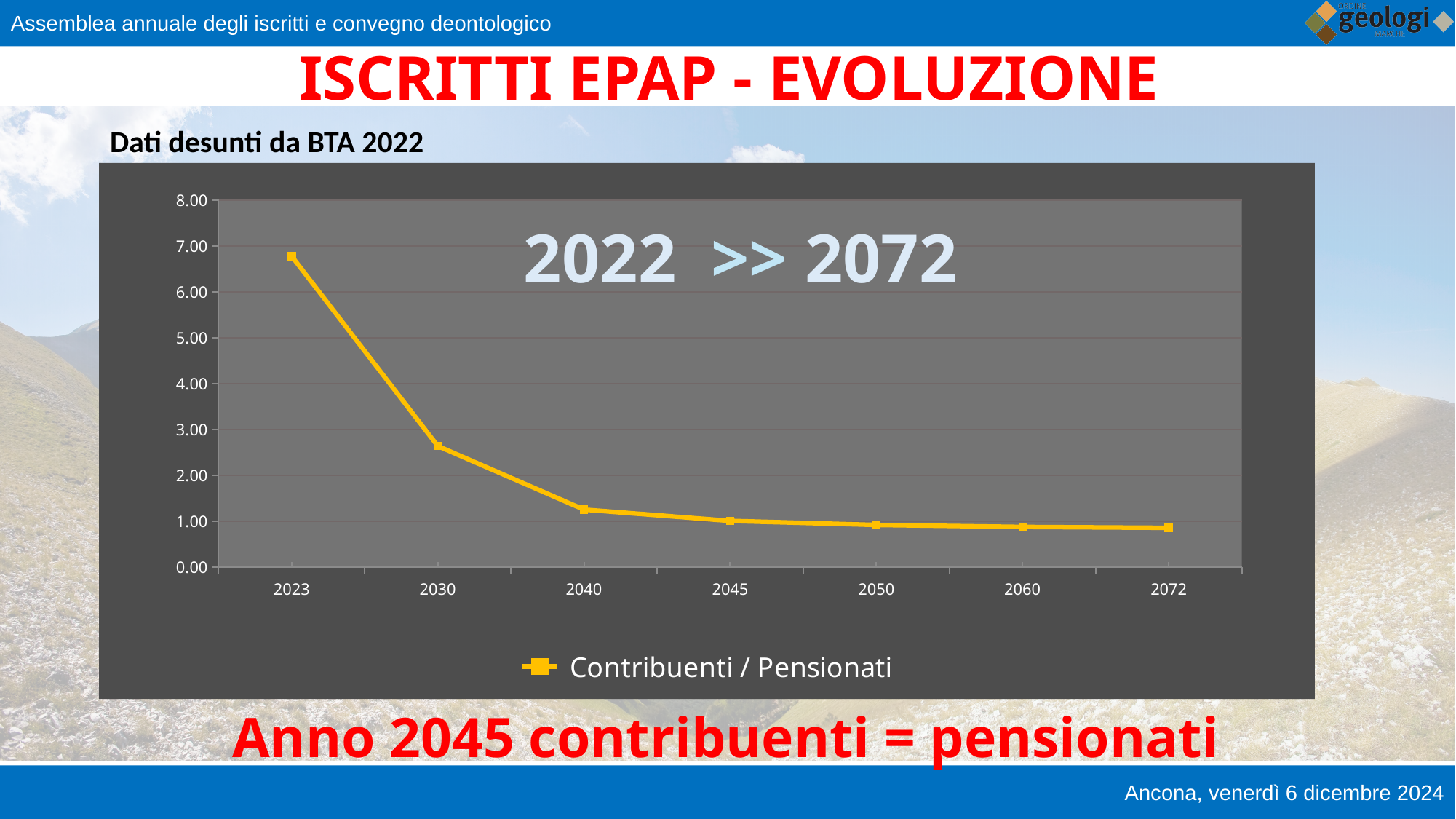
What is the name of the series shown in the chart legend? Contribuenti / Pensionati Which year has the larger value of Contribuenti / Pensionati, 2023 or 2030? 2023 Is the value for 2023 greater or less than 6.00? greater Is the value for 2072 greater or less than 1.00? less What kind of chart is shown on the slide? line chart Is the value for 2030 greater or less than 3.00? less Which year has the highest value of Contribuenti / Pensionati? 2023 How many years are plotted along the x axis of the chart? 7 Do the values of Contribuenti / Pensionati rise or fall from 2023 to 2072? fall What text is written inside the plot area of the chart? 2022 >> 2072 How many series does the chart legend list? 1